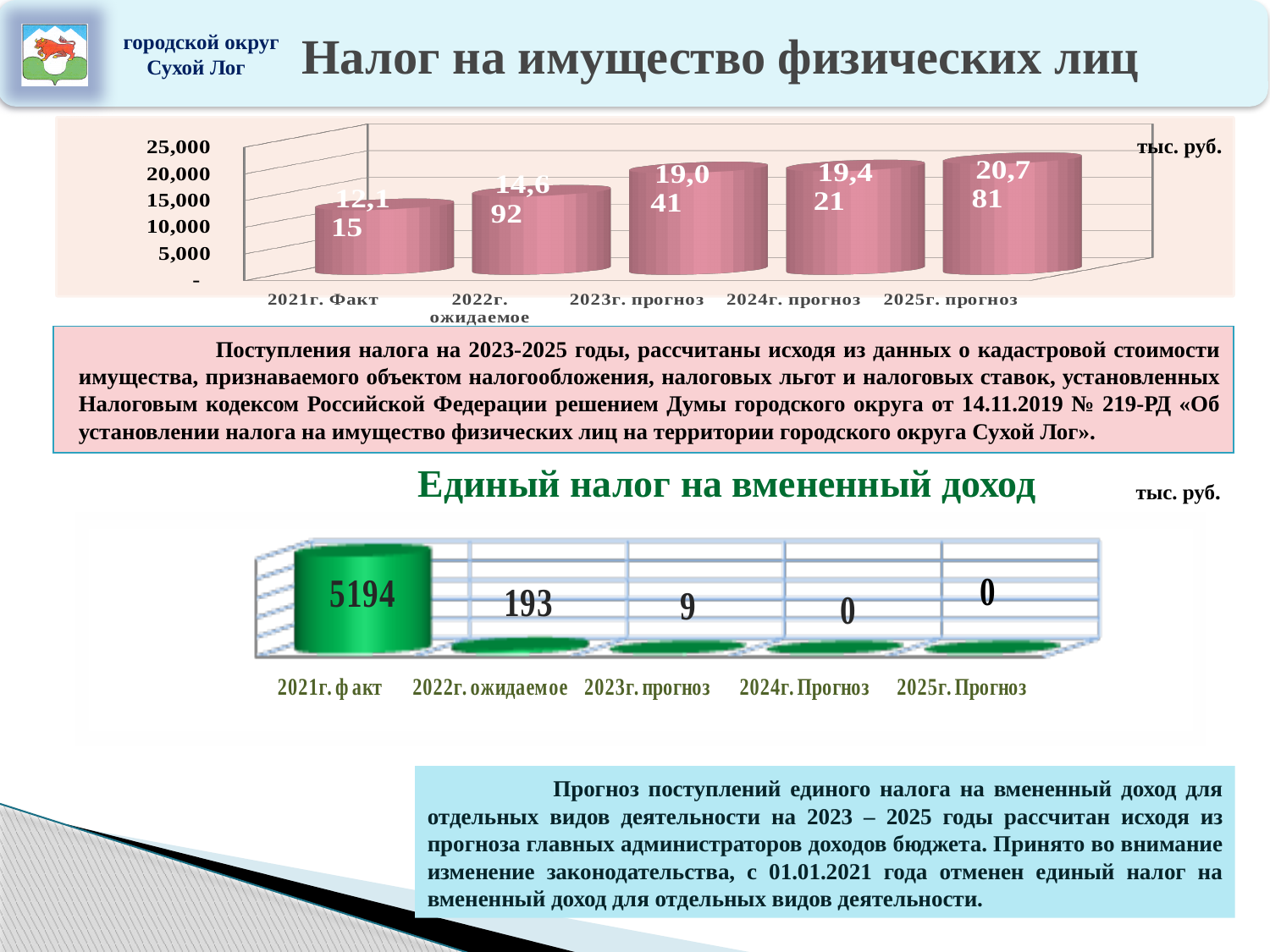
In the bottom chart 'Единый налог на вмененный доход', which is larger: the value for 2022г. ожидаемое or 2023г. прогноз? 2022г. ожидаемое In the top chart 'Налог на имущество физических лиц', do the values rise or fall from 2021 to 2025? rise How many categories are shown in the top chart 'Налог на имущество физических лиц'? 5 In the bottom chart 'Единый налог на вмененный доход', what is the value for 2022г. ожидаемое? 193 In the top chart 'Налог на имущество физических лиц', which category has the highest value? 2025г. прогноз In the top chart 'Налог на имущество физических лиц', is the value for 2025г. прогноз greater or less than 20,000? greater In the bottom chart 'Единый налог на вмененный доход', what is the difference between the values for 2021г. факт and 2022г. ожидаемое? 5001 In the top chart 'Налог на имущество физических лиц', is the value for 2021г. Факт greater or less than 15,000? less In the top chart 'Налог на имущество физических лиц', what is the value for 2025г. прогноз? 20,781 What type of chart is the bottom chart 'Единый налог на вмененный доход'? bar chart In the bottom chart 'Единый налог на вмененный доход', what is the value for 2021г. факт? 5194 In the top chart 'Налог на имущество физических лиц', which category has the lowest value? 2021г. Факт